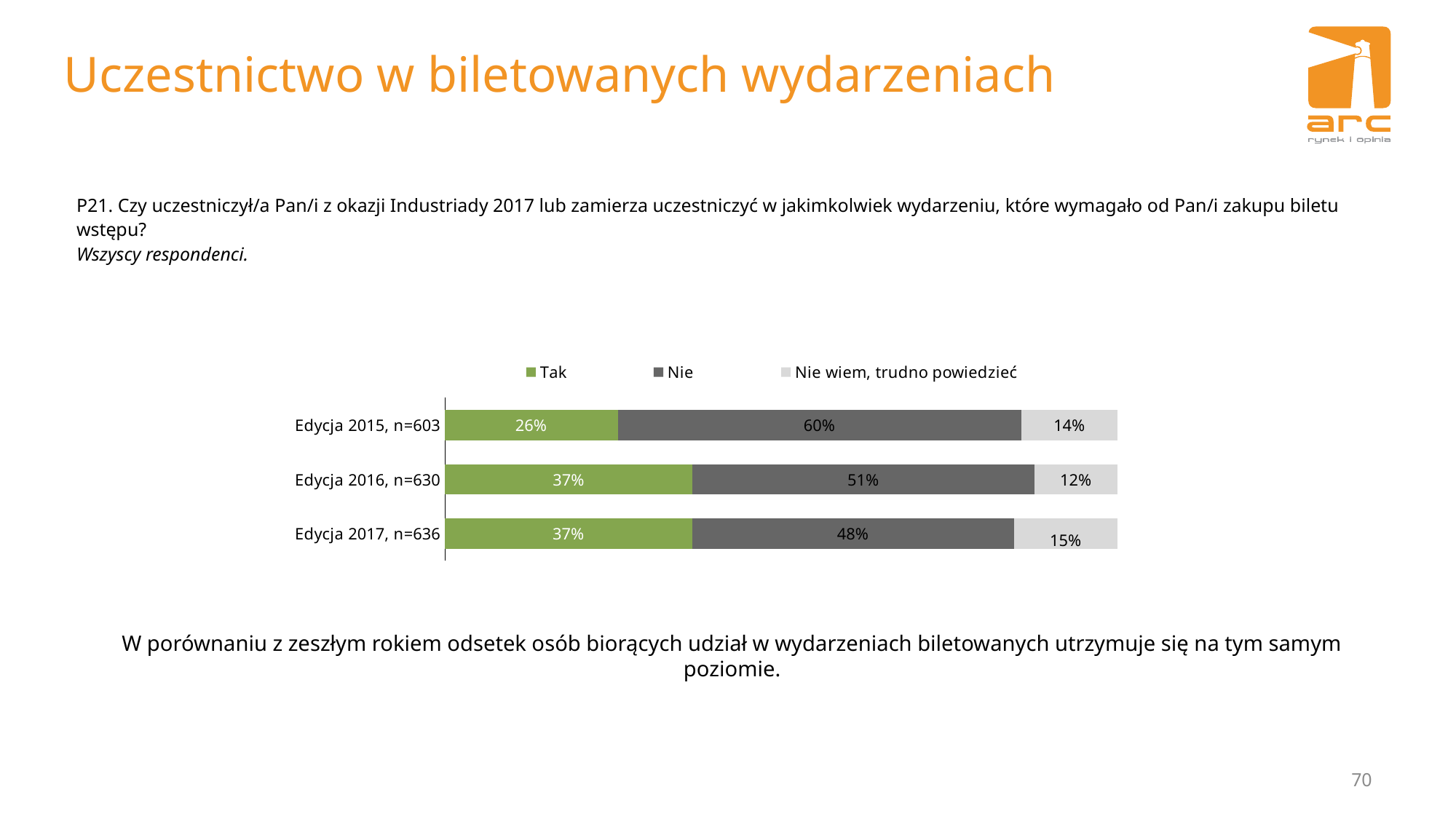
Which edition has the lowest value for "Tak"? Edycja 2015, n=603 What is the difference between the "Nie" values for Edycja 2015, n=603 and Edycja 2017, n=636? 12% What is the value for "Nie" for Edycja 2017, n=636? 48% Which is larger: the "Tak" value for Edycja 2016, n=630 or the "Tak" value for Edycja 2015, n=603? Edycja 2016, n=630 What kind of chart is shown on the slide? Stacked bar chart How many series does the legend list? 3 Which edition has the highest value for "Nie"? Edycja 2015, n=603 How many editions (bars) are shown in the chart? 3 What is the value for "Nie wiem, trudno powiedzieć" for Edycja 2016, n=630? 12% Which legend entry is shown in green? Tak What is the value for "Tak" for Edycja 2015, n=603? 26% What is the total of the stacked bar for Edycja 2015, n=603? 100%